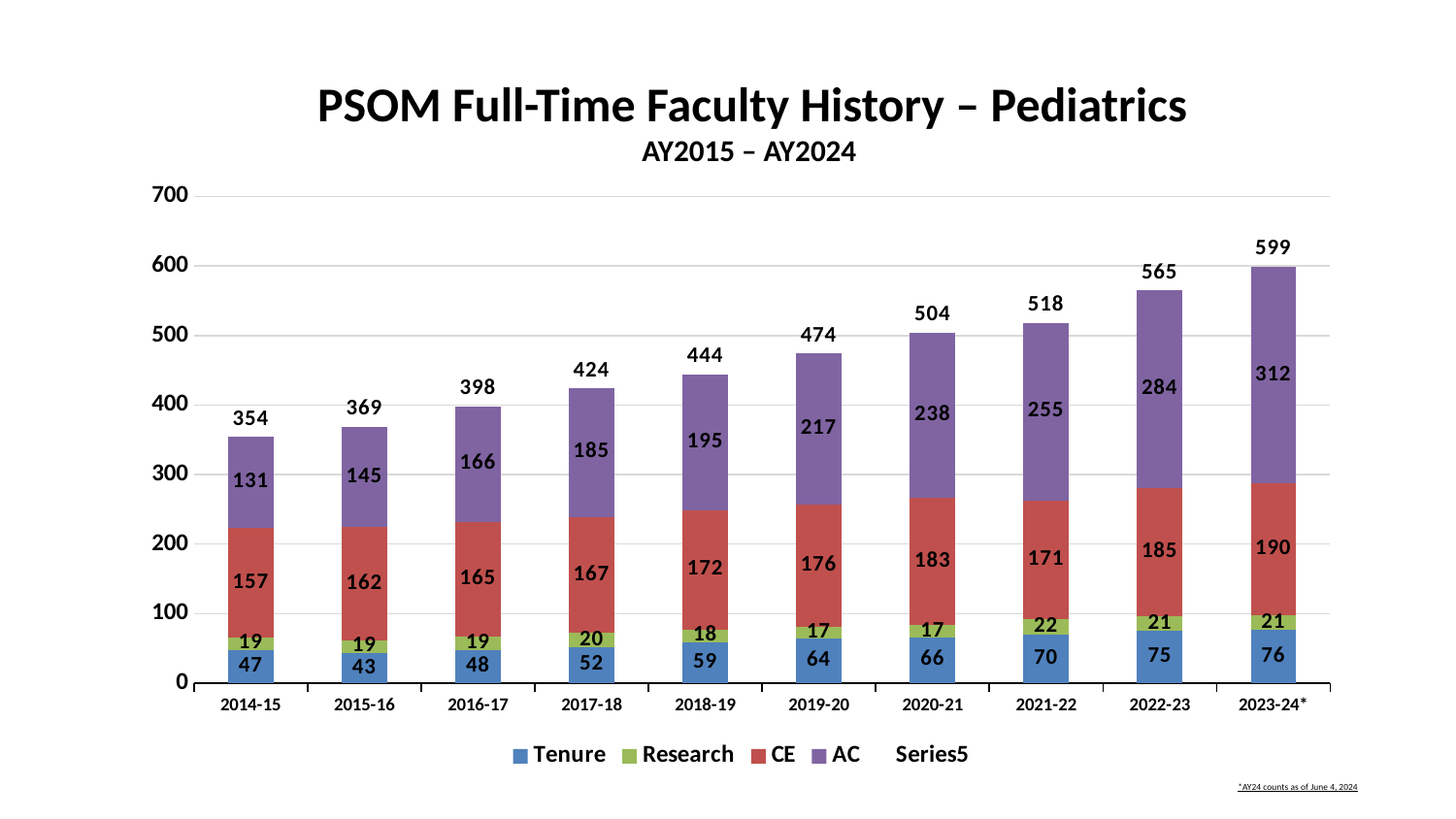
What is the total number of full-time Pediatrics faculty shown for 2023-24*? 599 Which academic year has the highest total full-time faculty count? 2023-24* Which is larger, the AC value for 2021-22 or the CE value for 2021-22? AC (255) What is the difference between the total for 2023-24* and the total for 2014-15? 245 What is the AC value for 2016-17? 166 Which academic year has the lowest total full-time faculty count? 2014-15 What is the CE value for 2020-21? 183 How many academic years are shown on the x axis? 10 Do the total faculty counts rise or fall from 2014-15 to 2023-24*? Rise What is the Tenure value for 2018-19? 59 How many entries does the legend list? 5 What kind of chart is shown on the slide? Stacked bar chart